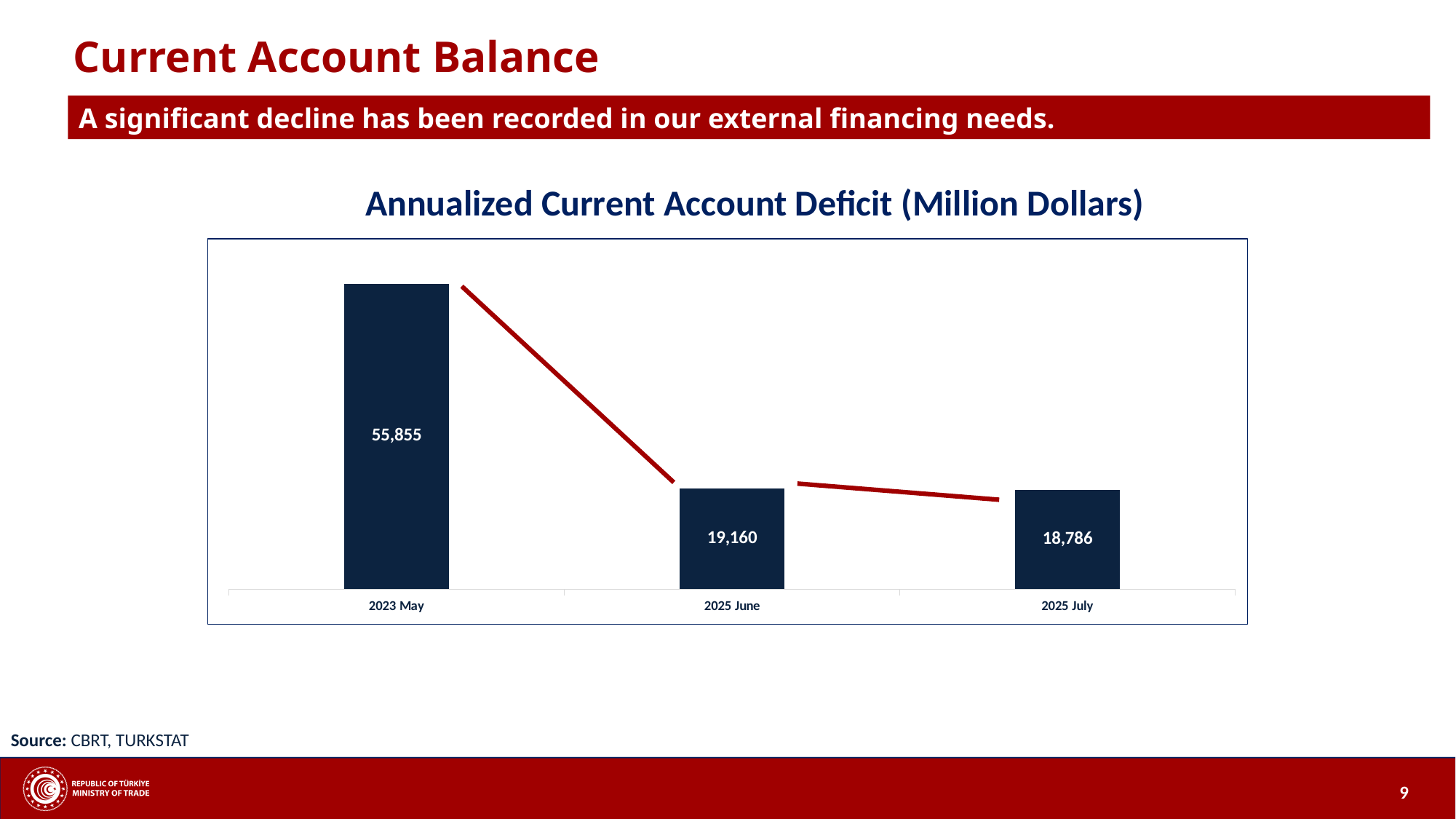
Which period has the highest annualized current account deficit? 2023 May What is the annualized current account deficit for 2025 June? 19,160 Which is larger, the deficit in 2023 May or in 2025 July? 2023 May What is the difference between the deficit in 2023 May and 2025 June? 36,695 What is the difference between the deficit in 2025 June and 2025 July? 374 What is the title of the chart? Annualized Current Account Deficit (Million Dollars) How many periods are shown on the chart? 3 What is the annualized current account deficit for 2023 May? 55,855 Do the values rise or fall from 2023 May to 2025 July? Fall Which period has the lowest annualized current account deficit? 2025 July What is the annualized current account deficit for 2025 July? 18,786 What kind of chart is used to show the annualized current account deficit? Bar chart